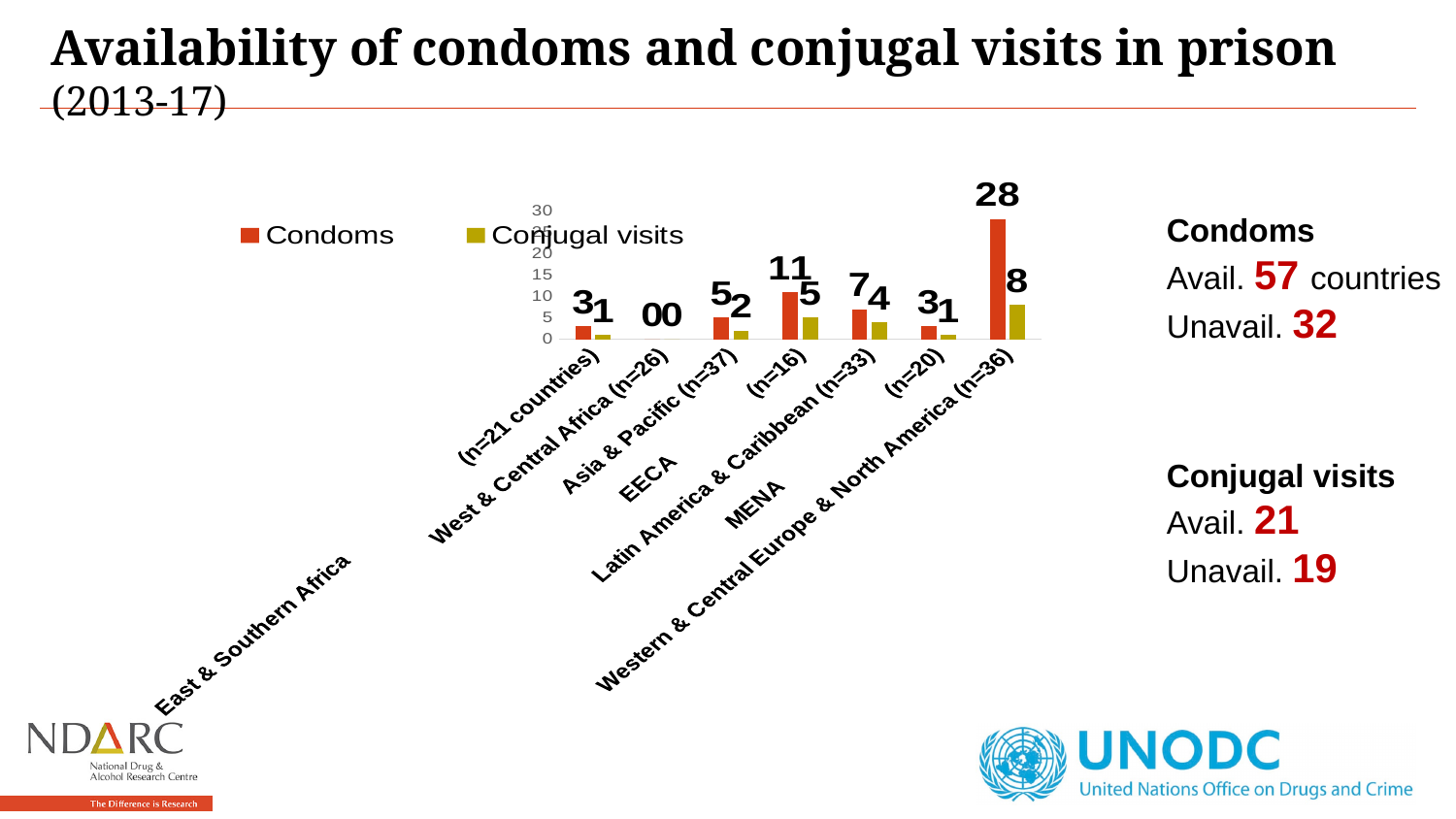
How many regions (categories) are shown on the x axis of the chart? 7 What is the Condoms value for Latin America & Caribbean (n=33)? 7 Is the Condoms value for Western & Central Europe & North America (n=36) greater or less than 20? greater Which is larger: the Condoms value for EECA (n=16) or the Condoms value for Asia & Pacific (n=37)? EECA (n=16) What is the Conjugal visits value for EECA (n=16)? 5 Which series is shown in red/orange in the chart legend? Condoms What is the difference between the Condoms and Conjugal visits values for Western & Central Europe & North America (n=36)? 20 How many series does the chart legend list? 2 Which region has the highest Condoms value? Western & Central Europe & North America (n=36) What is the Condoms value for Western & Central Europe & North America (n=36)? 28 What type of chart is shown on the slide? bar chart Which region has the lowest Conjugal visits value? West & Central Africa (n=26)